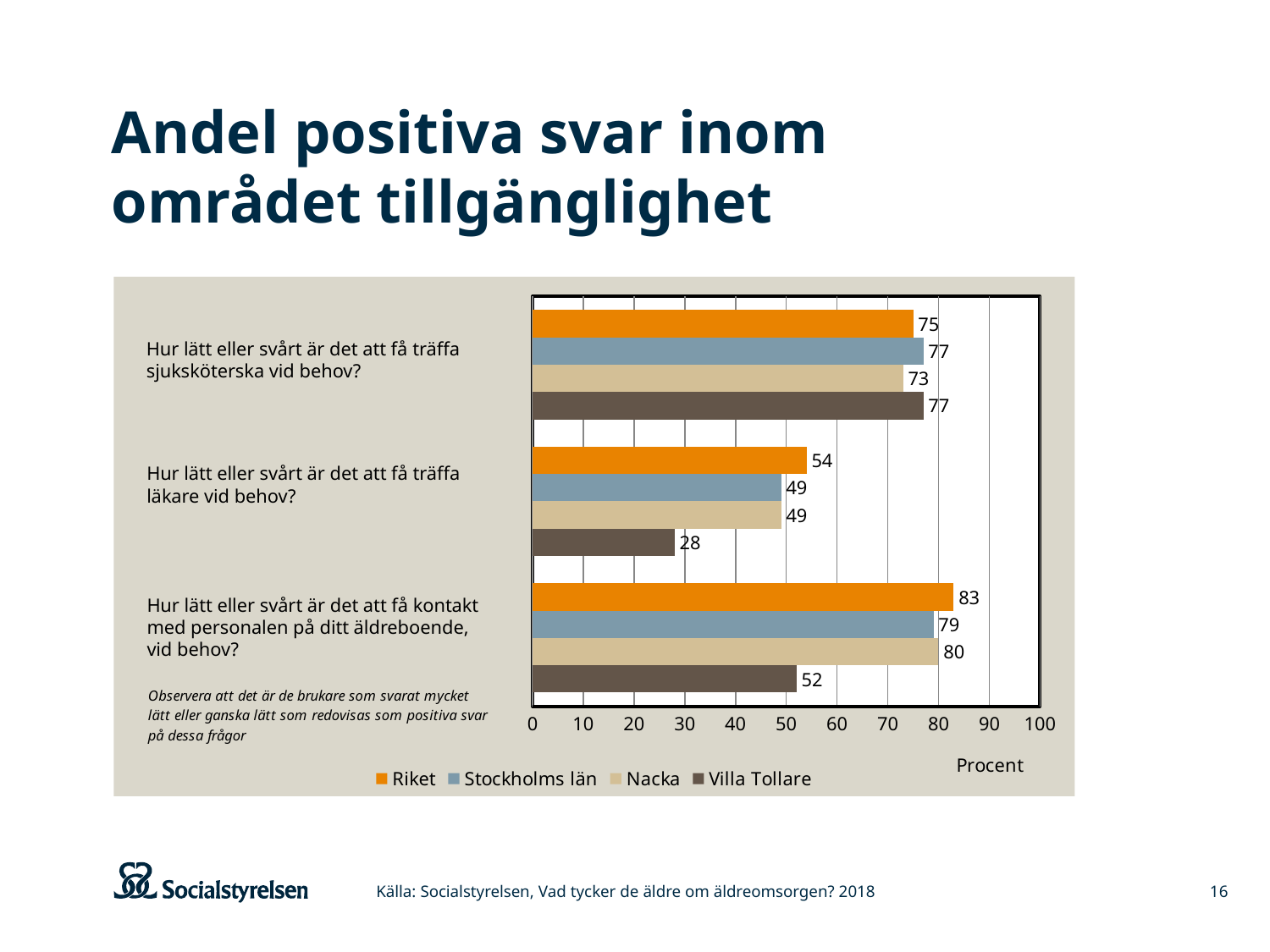
What is the difference between Riket and Villa Tollare on the question about getting in contact with staff at the care home? 31 What kind of chart is shown on the slide? Bar chart What is the value for Villa Tollare on the question about how easy or hard it is to meet a doctor when needed ("Hur lätt eller svårt är det att få träffa läkare vid behov?")? 28 How many questions (categories) are shown on the chart? 3 How many series does the legend list? 4 Which series has the lowest value on the question about meeting a doctor when needed? Villa Tollare What is the value for Nacka on the question about meeting a nurse when needed ("Hur lätt eller svårt är det att få träffa sjuksköterska vid behov?")? 73 What is the label of the horizontal axis? Procent Which is larger on the question about meeting a nurse when needed: Stockholms län or Nacka? Stockholms län What is the value for Riket on the question about getting in contact with staff at the care home ("Hur lätt eller svårt är det att få kontakt med personalen på ditt äldreboende, vid behov?")? 83 Is the value for Villa Tollare on the question about meeting a doctor when needed greater or less than 30? less Which series has the highest value on the question about getting in contact with staff at the care home? Riket